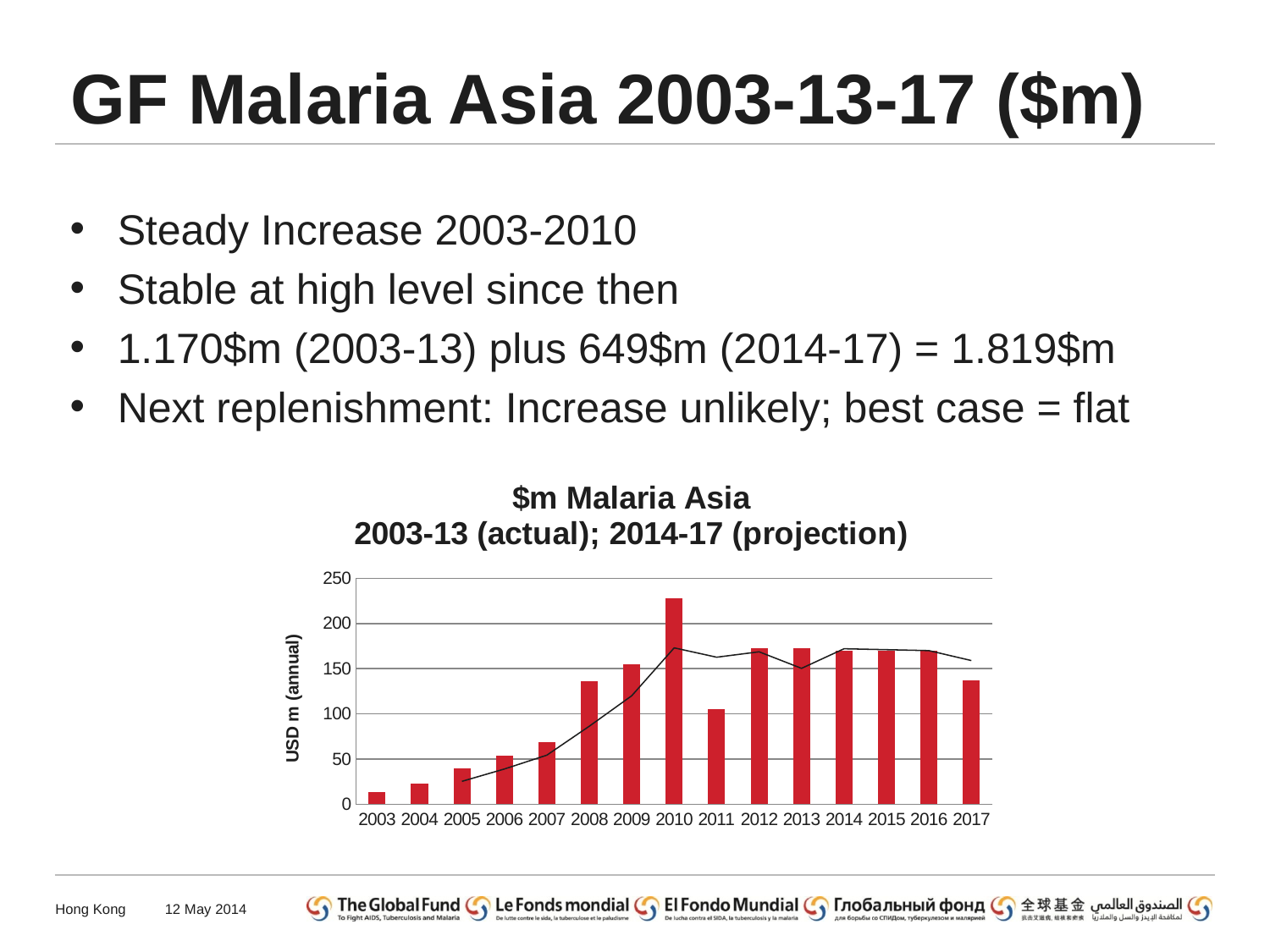
Which year has the highest bar in the chart? 2010 What kind of chart is shown on the slide? bar chart Is the value for 2011 greater or less than 150? less Which year has the larger bar, 2009 or 2007? 2009 Do the bar values rise or fall from 2003 to 2010? rise Which year has the larger bar, 2010 or 2011? 2010 What is the label on the y axis of the chart? USD m (annual) Is the value for 2010 greater or less than 200? greater Is the value for 2008 greater or less than 100? greater How many years are shown on the x axis of the chart? 15 Which year has the lowest bar in the chart? 2003